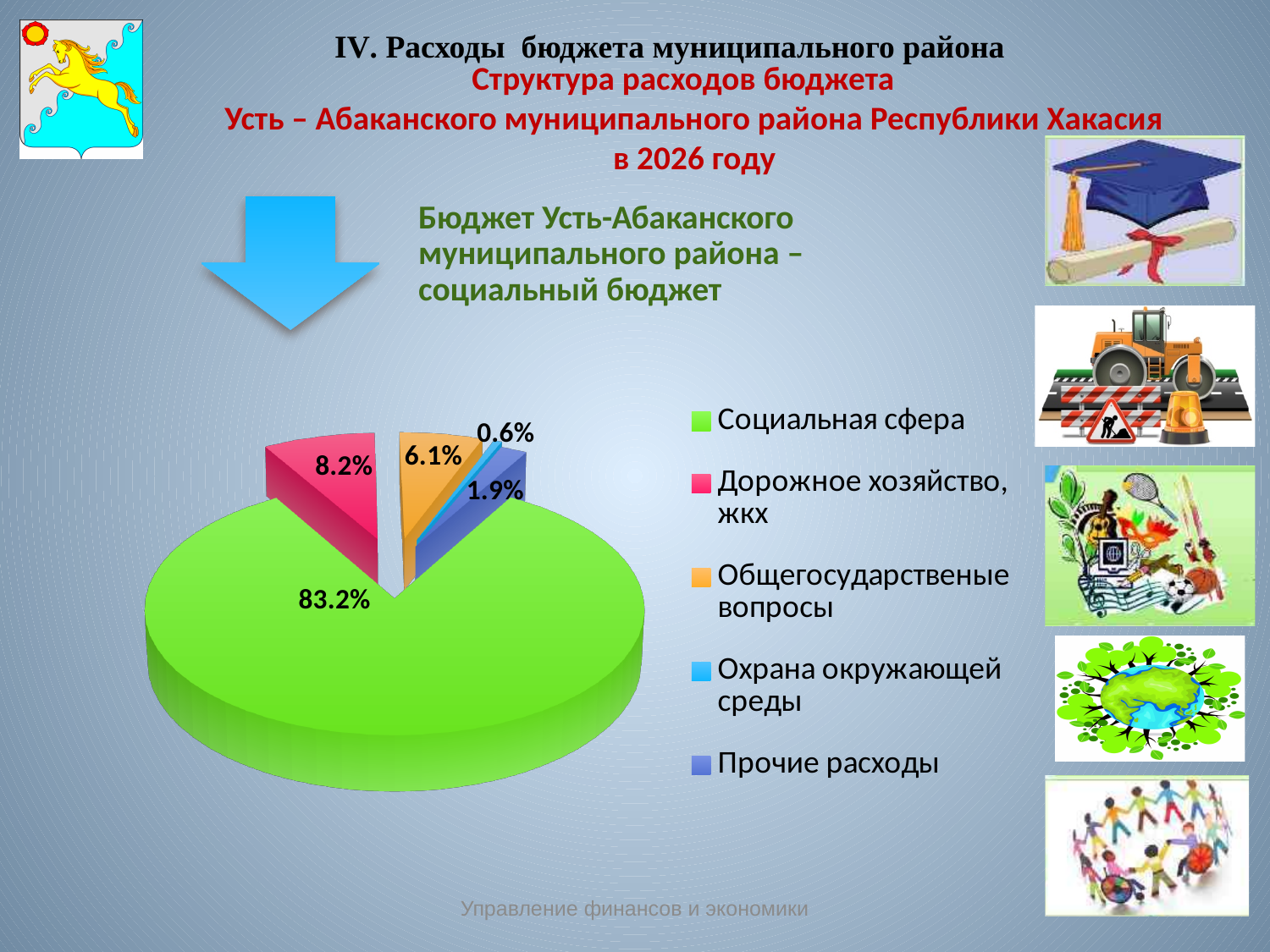
What share of the budget expenditure goes to Общегосударственые вопросы? 6.1% What share of the budget expenditure goes to Прочие расходы? 1.9% Which is larger: the share for Прочие расходы or the share for Охрана окружающей среды? Прочие расходы Which category has the smallest share of the pie? Охрана окружающей среды What kind of chart is shown on the slide? Pie chart How many categories does the pie chart show? 5 Which category has the largest share of the pie? Социальная сфера What share of the budget expenditure goes to Охрана окружающей среды? 0.6% What share of the budget expenditure goes to Дорожное хозяйство, жкх? 8.2% What colour is the slice for Социальная сфера? Green What share of the budget expenditure goes to Социальная сфера? 83.2% What is the difference in percentage points between Дорожное хозяйство, жкх and Общегосударственые вопросы? 2.1